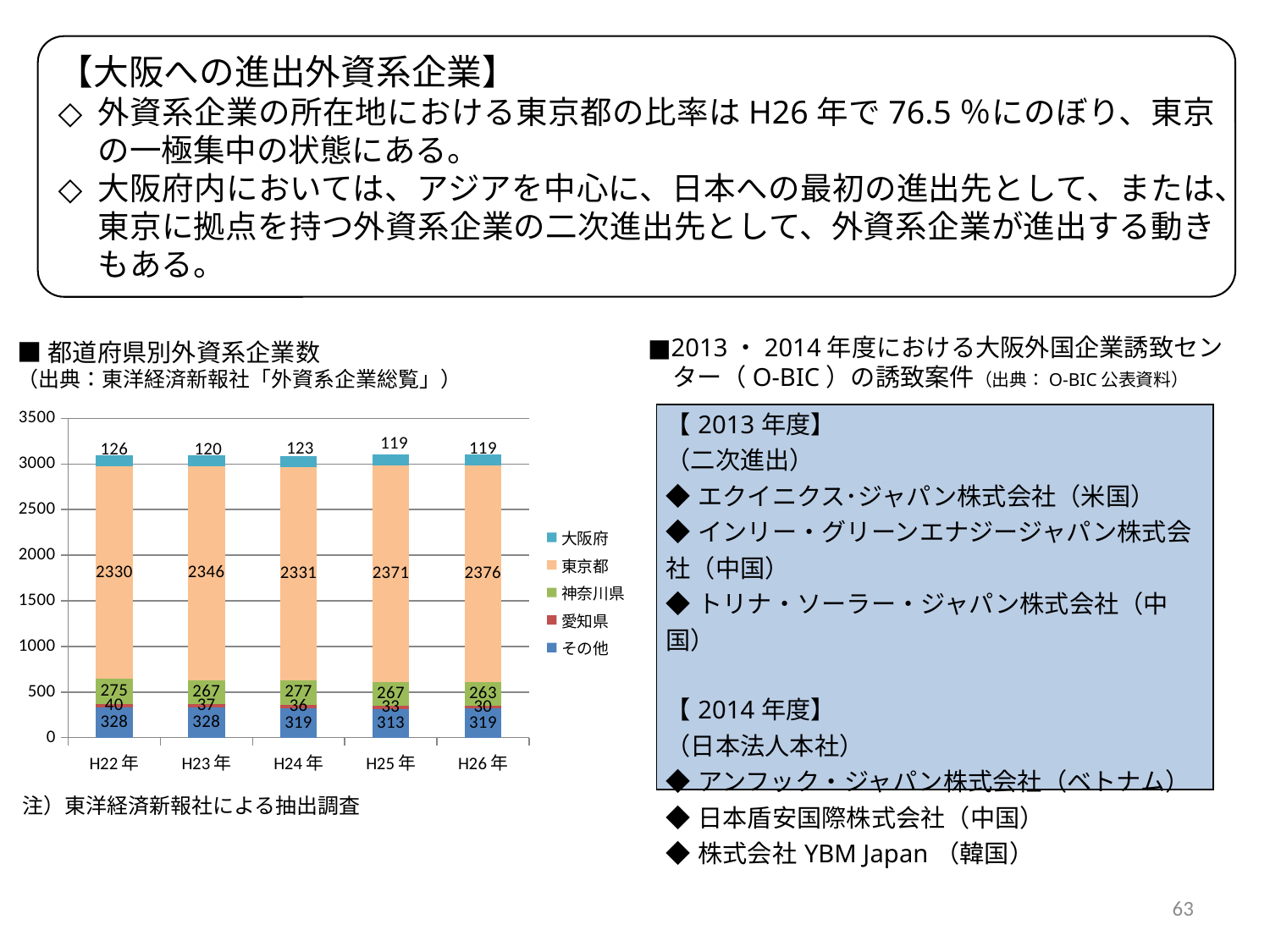
What is the value for 東京都 in H26年? 2376 How many years are shown on the x axis? 5 Which is larger, the 大阪府 value in H22年 or in H23年? H22年 How many series does the legend list? 5 What kind of chart is shown? Stacked bar chart What is the total of the stacked bar for H22年? 3099 What is the value for 大阪府 in H22年? 126 In which year is the value for 愛知県 the lowest? H26年 What is the value for 神奈川県 in H24年? 277 What is the difference between the 東京都 values for H26年 and H22年? 46 What is the value for 愛知県 in H26年? 30 In which year is the value for 東京都 the highest? H26年